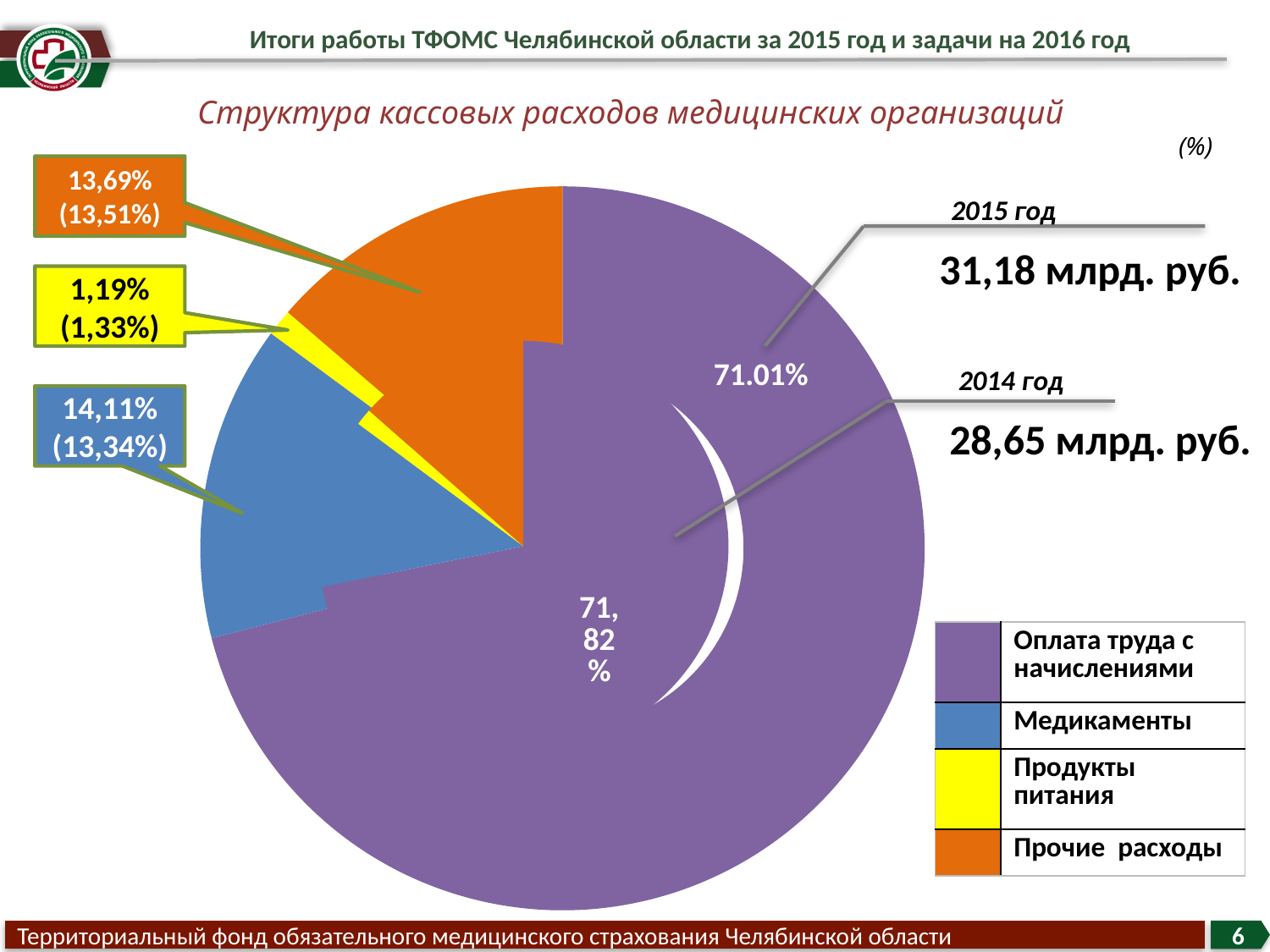
What is the share of 'Продукты питания' in 2015? 1,19% Which category has the smallest share of cash expenditures? Продукты питания Which category has the largest share of cash expenditures? Оплата труда с начислениями What is the share of 'Медикаменты' in 2014 (the value in parentheses)? 13,34% In 2015, which share is larger: 'Медикаменты' or 'Прочие расходы'? Медикаменты What share of cash expenditures did 'Оплата труда с начислениями' account for in 2014? 71,82% What is the share of 'Медикаменты' in 2015? 14,11% What kind of chart is shown on the slide? pie chart What is the share of 'Прочие расходы' in 2014 (the value in parentheses)? 13,51% What total amount of cash expenditures is shown for 2015 год? 31,18 млрд. руб. How many expenditure categories does the legend list? 4 What share of cash expenditures did 'Оплата труда с начислениями' account for in 2015? 71.01%